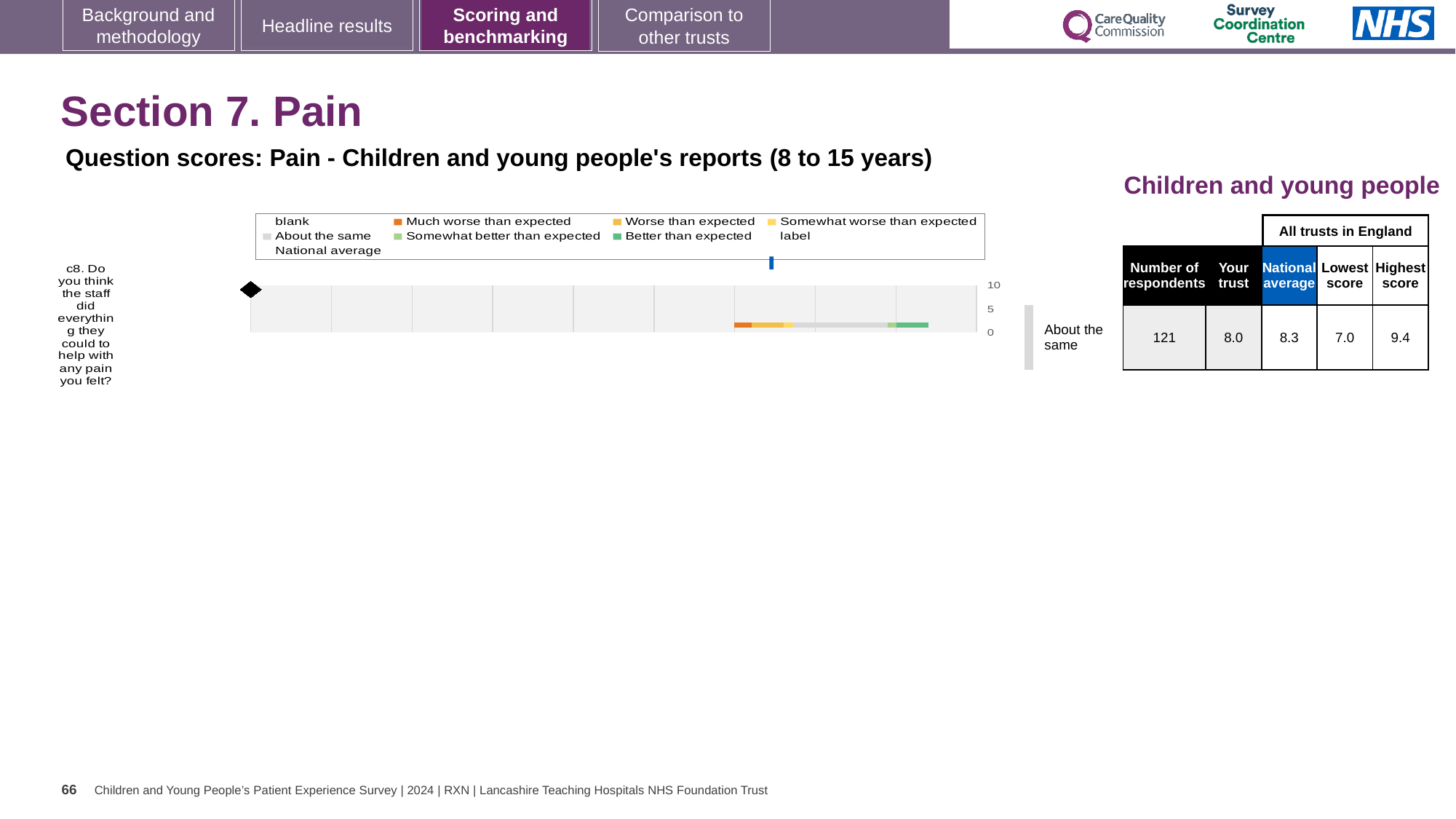
How many survey questions are plotted in the chart? 1 What is the 'Your trust' score for question c8 shown in the table beside the chart? 8.0 What benchmark category is the trust's result for question c8 placed in? About the same Which legend entry is shown in orange? Much worse than expected What kind of chart is shown on the slide? bar chart What is the difference between the highest and lowest trust scores for question c8? 2.4 What is the highest score among all trusts in England for question c8? 9.4 What is the highest tick value shown on the chart's score axis? 10 What is the lowest score among all trusts in England for question c8? 7.0 How many respondents answered question c8 according to the table beside the chart? 121 Which is larger for question c8: the 'Your trust' score or the national average? National average What is the national average score for question c8 shown in the table beside the chart? 8.3